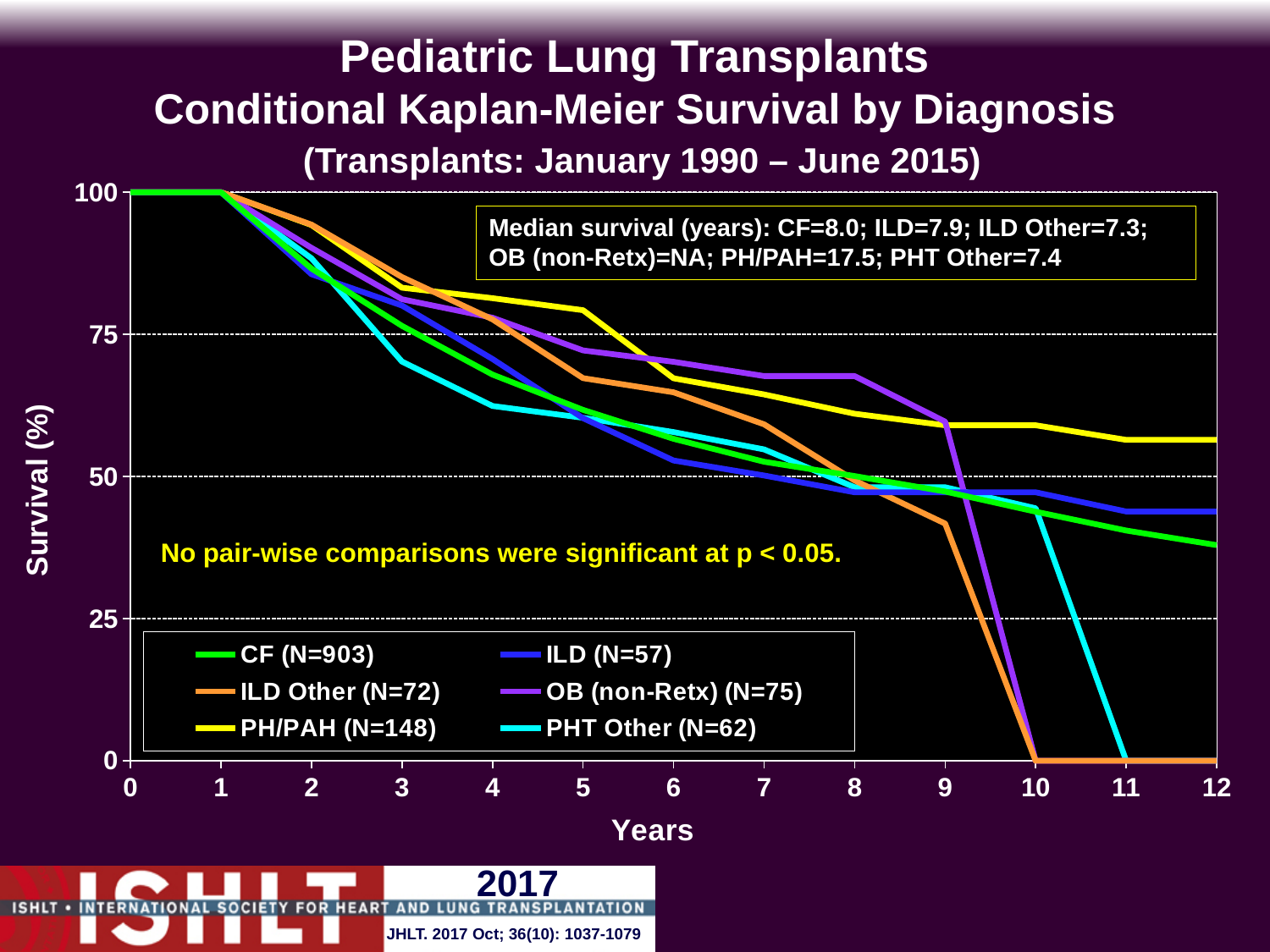
What kind of chart is shown on the slide? line chart Is the survival for CF at year 12 greater or less than 50? less At year 3, which is larger: the survival for PH/PAH or for PHT Other? PH/PAH What is the N shown in the legend for CF? 903 According to the text box, what is the median survival for OB (non-Retx)? NA Do the survival curves rise or fall as years increase? fall According to the text box, what is the median survival in years for PH/PAH? 17.5 What is the survival (%) for CF at year 1? 100 Is the survival for OB (non-Retx) at year 8 greater or less than 50? greater According to the text box, what is the median survival in years for CF? 8.0 Which diagnosis has the highest survival at year 12? PH/PAH How many series does the legend list? 6